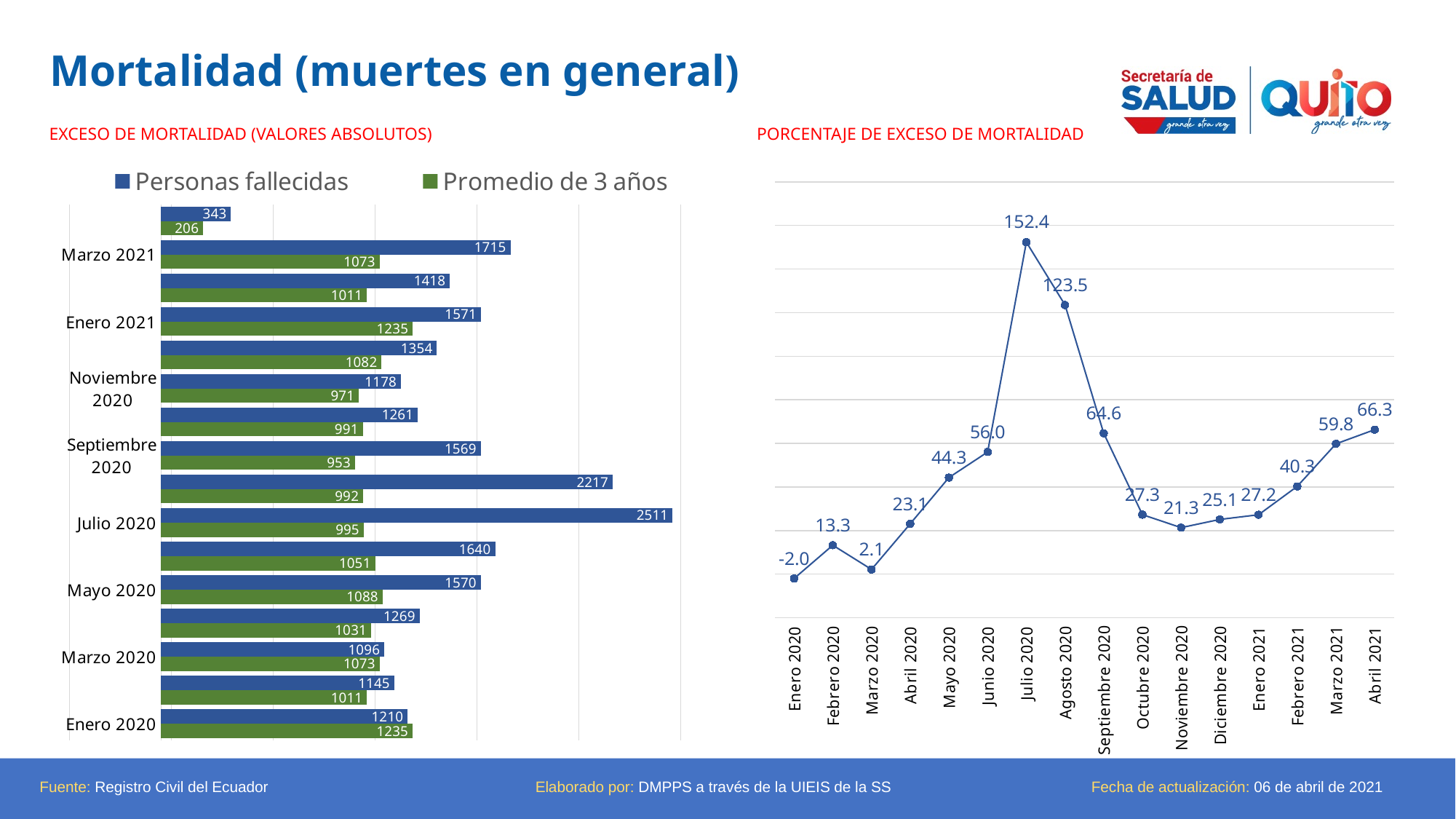
How many data points are plotted in the chart 'PORCENTAJE DE EXCESO DE MORTALIDAD'? 16 In the chart 'EXCESO DE MORTALIDAD (VALORES ABSOLUTOS)', what is the difference between Personas fallecidas and Promedio de 3 años for Julio 2020? 1516 What kind of chart is 'EXCESO DE MORTALIDAD (VALORES ABSOLUTOS)'? Bar chart In the chart 'EXCESO DE MORTALIDAD (VALORES ABSOLUTOS)', which is larger for Personas fallecidas: Mayo 2020 or Marzo 2020? Mayo 2020 In the chart 'PORCENTAJE DE EXCESO DE MORTALIDAD', do the values rise or fall from Julio 2020 to Noviembre 2020? Fall In the chart 'EXCESO DE MORTALIDAD (VALORES ABSOLUTOS)', what is the value of Personas fallecidas for Julio 2020? 2511 How many series does the legend of the chart 'EXCESO DE MORTALIDAD (VALORES ABSOLUTOS)' list? 2 In the chart 'EXCESO DE MORTALIDAD (VALORES ABSOLUTOS)', which month has the highest value of Personas fallecidas? Julio 2020 In the chart 'PORCENTAJE DE EXCESO DE MORTALIDAD', which month has the lowest value? Enero 2020 In the chart 'PORCENTAJE DE EXCESO DE MORTALIDAD', what is the difference between the values for Julio 2020 and Agosto 2020? 28.9 In the chart 'PORCENTAJE DE EXCESO DE MORTALIDAD', what is the value for Julio 2020? 152.4 In the chart 'EXCESO DE MORTALIDAD (VALORES ABSOLUTOS)', what is the value of Promedio de 3 años for Enero 2021? 1235